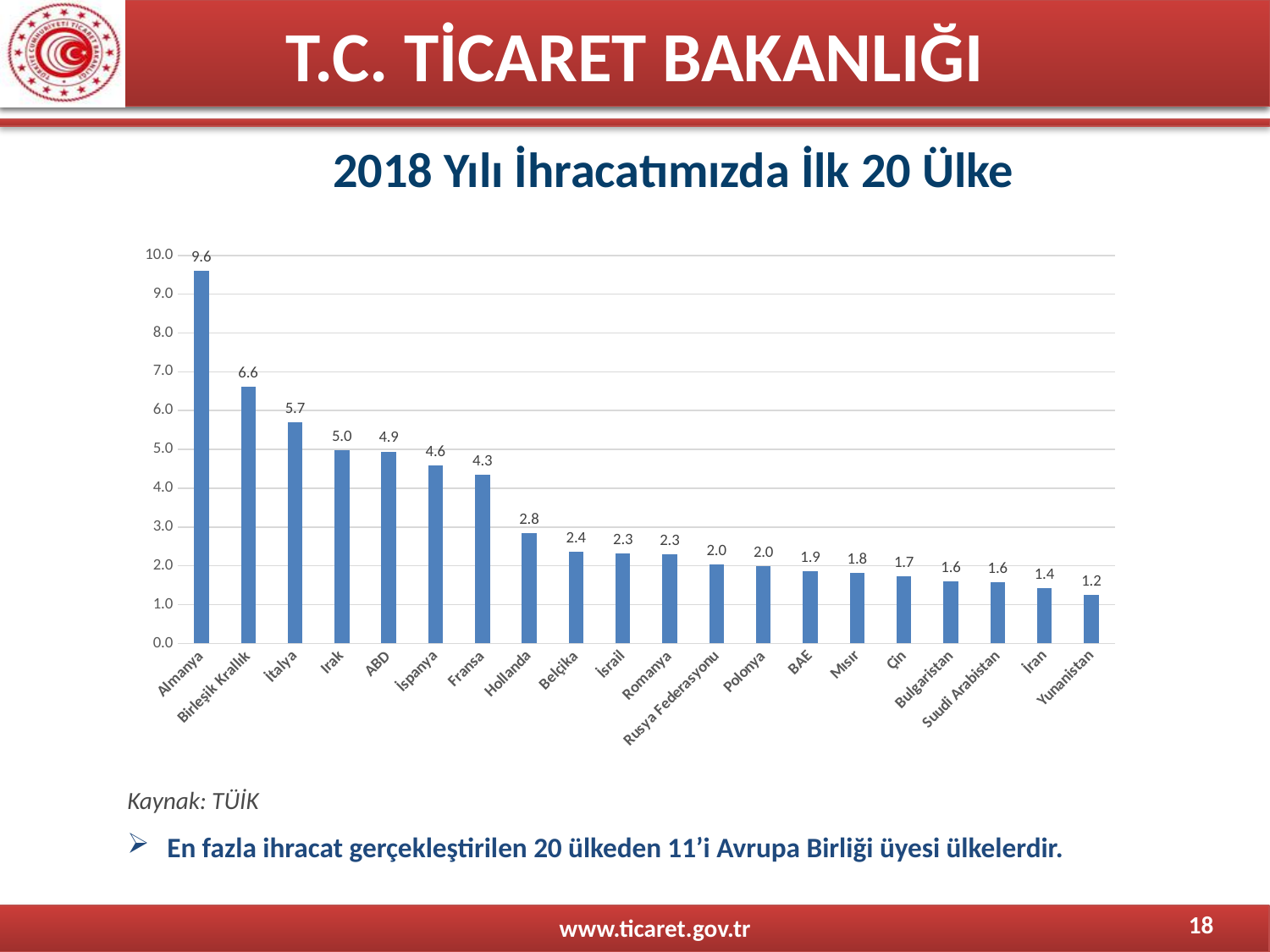
Is the value for Fransa greater or less than 4.0? greater Which country has the highest value? Almanya What is the title of the chart? 2018 Yılı İhracatımızda İlk 20 Ülke What is the value for Almanya? 9.6 Do the values rise or fall from left to right along the x axis? fall Which country has the lowest value? Yunanistan What is the difference between the values for Almanya and Birleşik Krallık? 3.0 What kind of chart is shown on the slide? bar chart Which is larger, the value for İtalya or the value for Irak? İtalya What is the value for Yunanistan? 1.2 How many countries are shown in the chart? 20 What is the value for Hollanda? 2.8